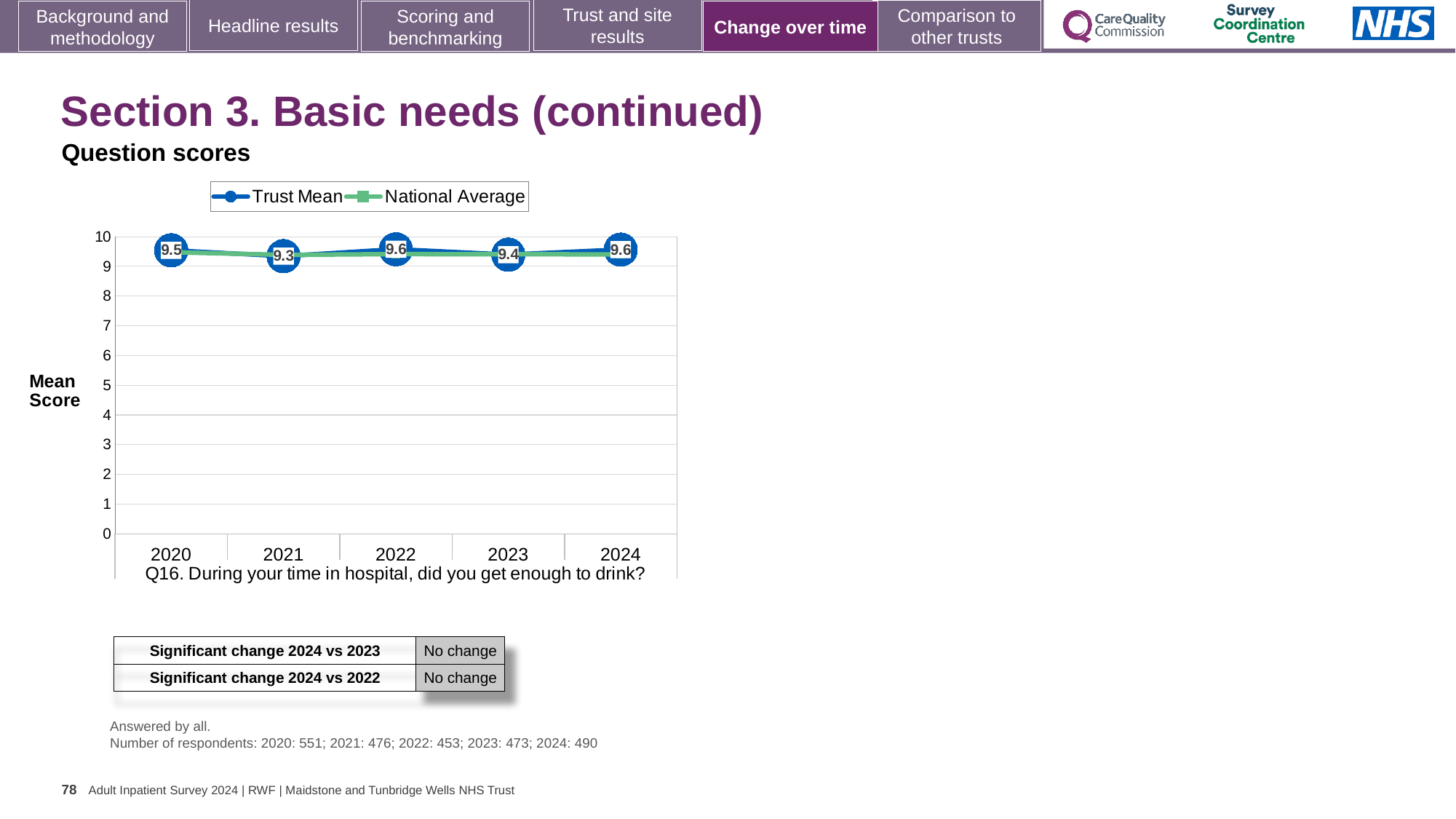
What is the Trust Mean score for 2024? 9.6 Is the National Average value for 2024 greater or less than 8? greater What kind of chart is shown on the slide? line chart Which year has the higher Trust Mean score, 2020 or 2021? 2020 In which year is the Trust Mean score lowest? 2021 Did the Trust Mean score rise or fall from 2020 to 2021? fall What is the difference between the Trust Mean scores for 2022 and 2021? 0.3 What is the Trust Mean score for 2023? 9.4 What is the Trust Mean score for 2021? 9.3 How many series does the legend list? 2 How many years are plotted on the x axis? 5 What is the Trust Mean score for 2020? 9.5